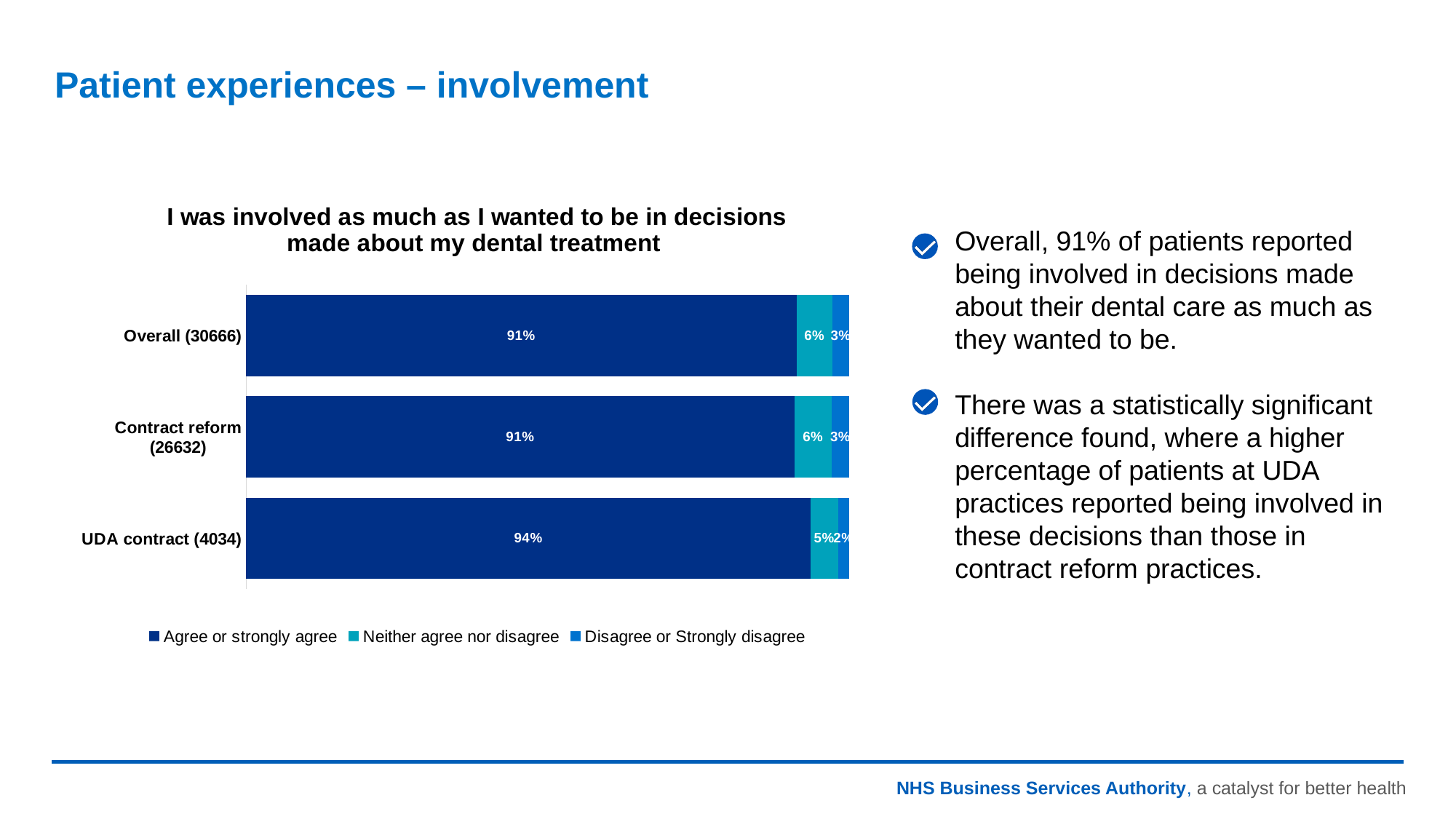
How many categories are shown on the chart? 3 What is the total of the stacked bar for Overall (30666)? 100% What is the title of the chart? I was involved as much as I wanted to be in decisions made about my dental treatment How many series does the legend list? 3 What is the difference in the 'Agree or strongly agree' percentage between UDA contract (4034) and Contract reform (26632)? 3 percentage points Which category has the highest percentage of respondents who agree or strongly agree? UDA contract (4034) What kind of chart is shown on the slide? Stacked bar chart What percentage of Overall (30666) respondents agree or strongly agree? 91% What percentage of UDA contract (4034) respondents agree or strongly agree? 94% Which has a larger 'Neither agree nor disagree' share, Overall (30666) or UDA contract (4034)? Overall (30666) What percentage of Contract reform (26632) respondents neither agree nor disagree? 6% What percentage of UDA contract (4034) respondents disagree or strongly disagree? 2%